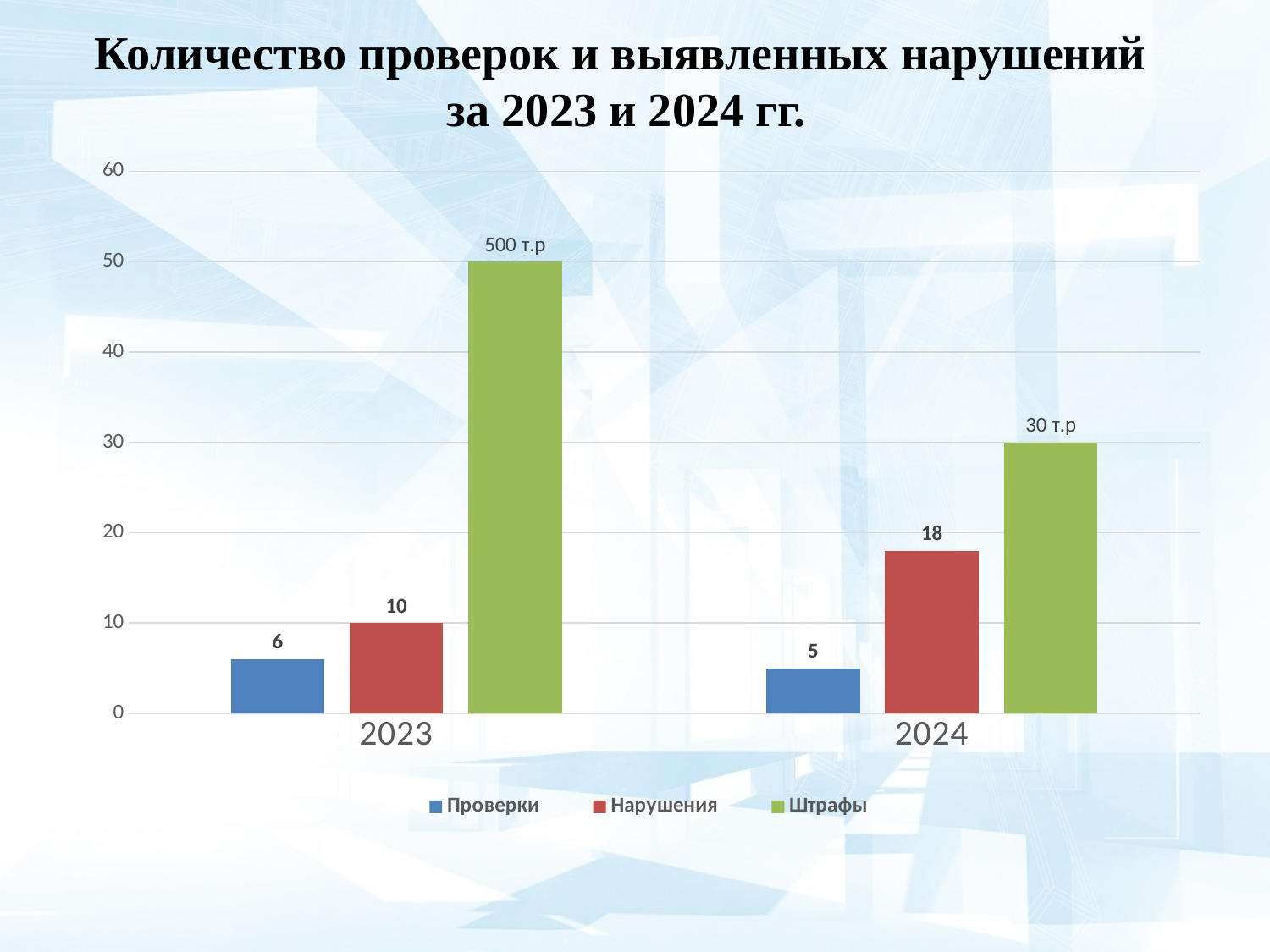
What label is shown on the Штрафы bar for 2024? 30 т.р How many series does the legend list? 3 What is the difference between the Нарушения values for 2024 and 2023? 8 What label is shown on the Штрафы bar for 2023? 500 т.р Did the value of Проверки rise or fall from 2023 to 2024? fall What is the value of Проверки for 2024? 5 What is the value of Проверки for 2023? 6 How many year categories are shown on the x axis? 2 What is the value of Нарушения for 2024? 18 What kind of chart is shown on the slide? bar chart Which year has the higher value for Нарушения? 2024 Which colour represents the Штрафы series in the legend? green